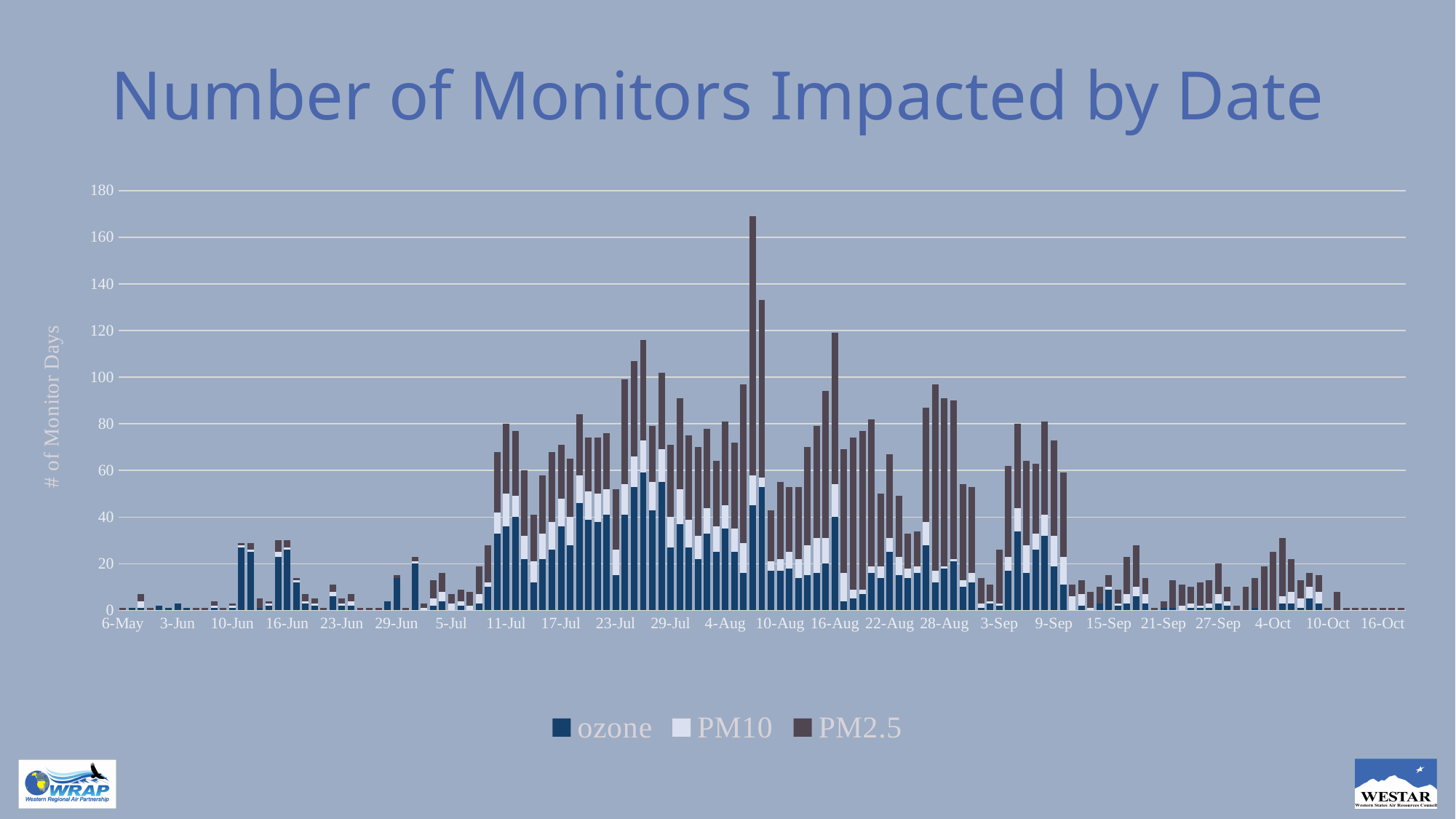
Do the total values generally rise or fall from 6-May to 4-Aug? rise Is the tallest bar on the chart greater or less than 160? greater What kind of chart is shown on the slide? Stacked bar chart Do the total values generally rise or fall from 28-Aug to 16-Oct? fall Is the total value for 11-Jul greater or less than 40? greater How many series does the legend list? 3 Is the total value for 28-Aug greater or less than 60? greater What is the label on the vertical axis? # of Monitor Days What is the title of the chart? Number of Monitors Impacted by Date